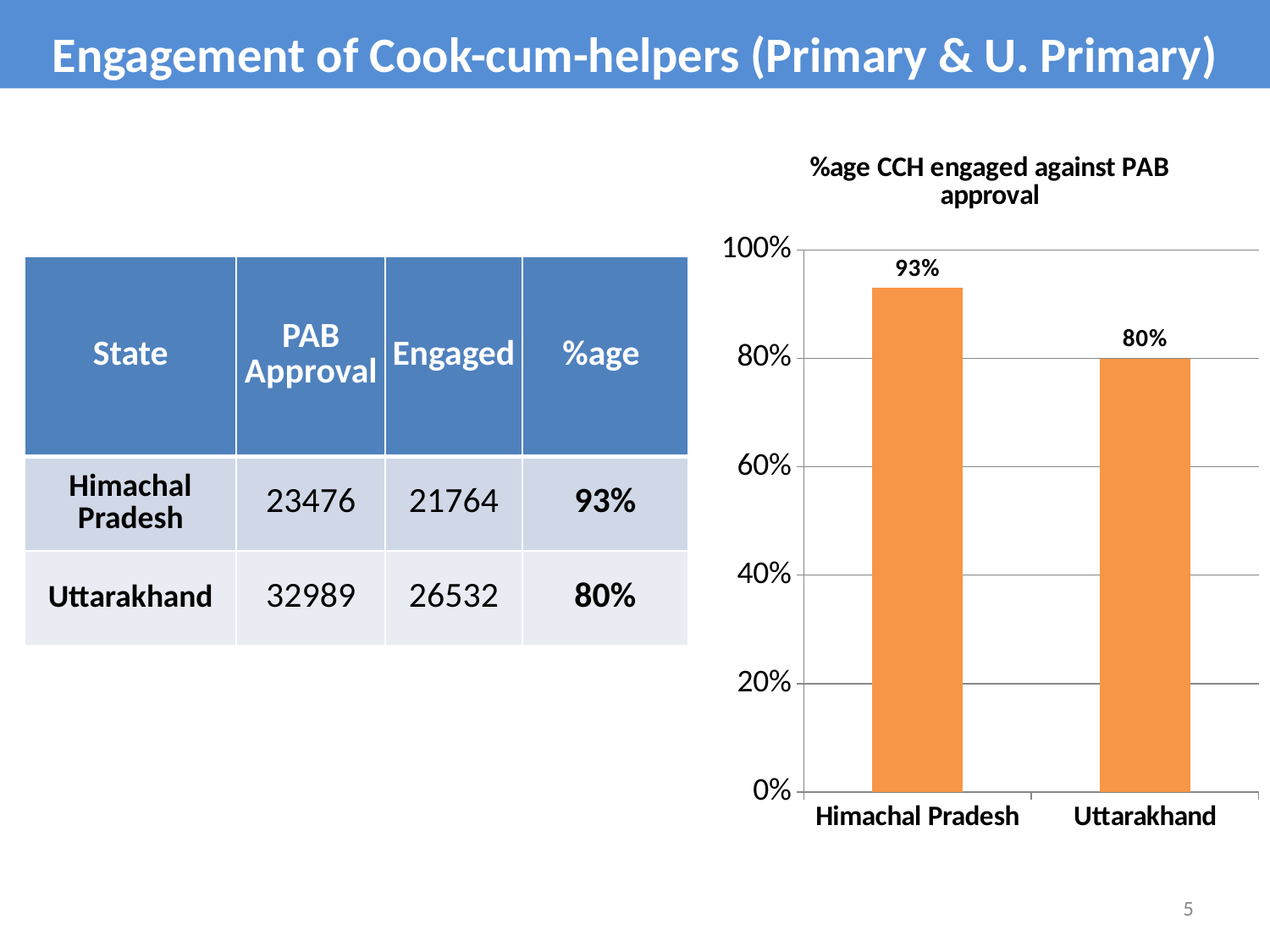
What is the difference in percentage points between Himachal Pradesh and Uttarakhand? 13% How many states are shown in the chart? 2 What is the value for Uttarakhand in the chart? 80% Which state has a larger value, Himachal Pradesh or Uttarakhand? Himachal Pradesh What is the value for Himachal Pradesh in the chart? 93% Is the value for Uttarakhand greater or less than 100%? less Which state has the highest percentage of CCH engaged against PAB approval? Himachal Pradesh What colour are the bars in the chart? Orange Which state has the lowest percentage of CCH engaged against PAB approval? Uttarakhand Is the value for Himachal Pradesh greater or less than 80%? greater What kind of chart is shown on the slide? Bar chart What is the title of the chart? %age CCH engaged against PAB approval